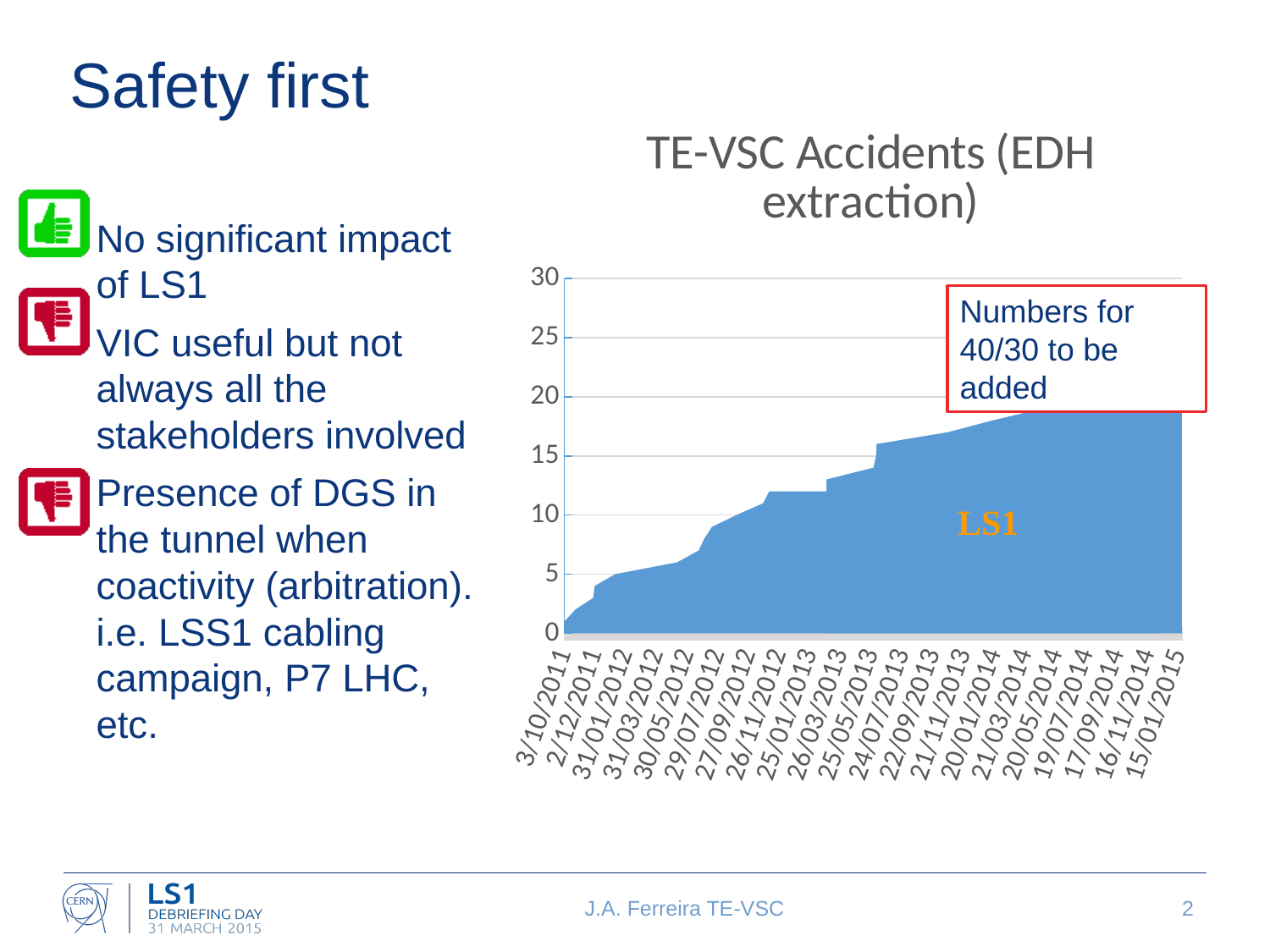
Is the value at 3/10/2011 greater or less than 5? less What kind of chart is shown on the slide? area chart What is the highest value shown on the chart's y axis? 30 Is the value at 27/09/2012 greater or less than 15? less Which date is the first label on the chart's x axis? 3/10/2011 Do the values in the chart rise or fall from left to right along the x axis? rise Is the value at 15/01/2015 greater or less than 15? greater What is the title of the chart? TE-VSC Accidents (EDH extraction)